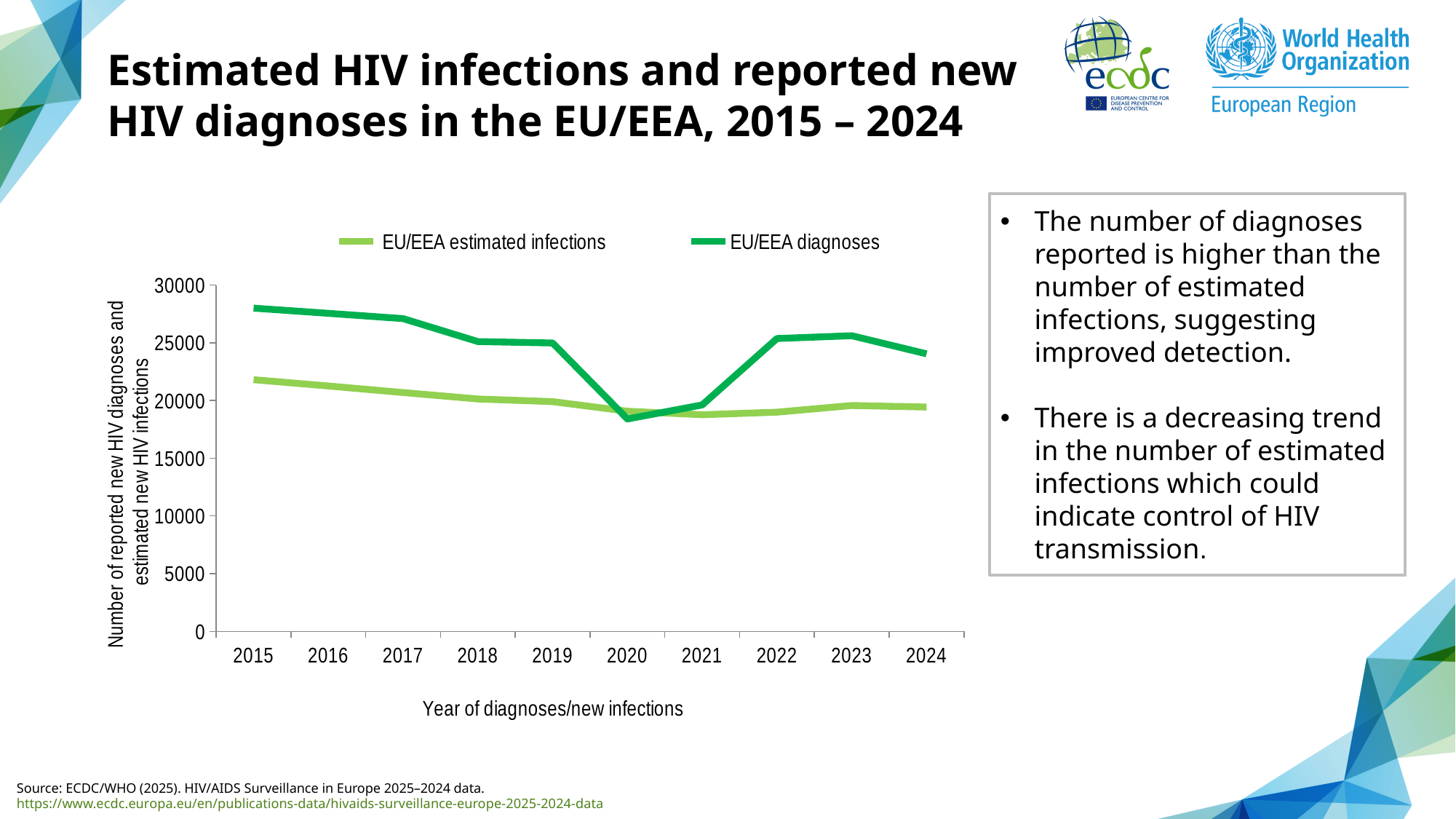
How many years are plotted along the x axis? 10 Is the value for EU/EEA diagnoses in 2024 greater or less than 25000? less How many series does the legend list? 2 In 2022, which series has the larger value: EU/EEA estimated infections or EU/EEA diagnoses? EU/EEA diagnoses Is the value for EU/EEA diagnoses in 2015 greater or less than 25000? greater What kind of chart is shown on the slide? Line chart In which year is the EU/EEA diagnoses line at its highest? 2015 Is the value for EU/EEA diagnoses in 2020 greater or less than 20000? less Does the EU/EEA estimated infections line generally rise or fall from 2015 to 2024? Fall In which year is the EU/EEA diagnoses line at its lowest? 2020 In which year is the EU/EEA estimated infections line at its highest? 2015